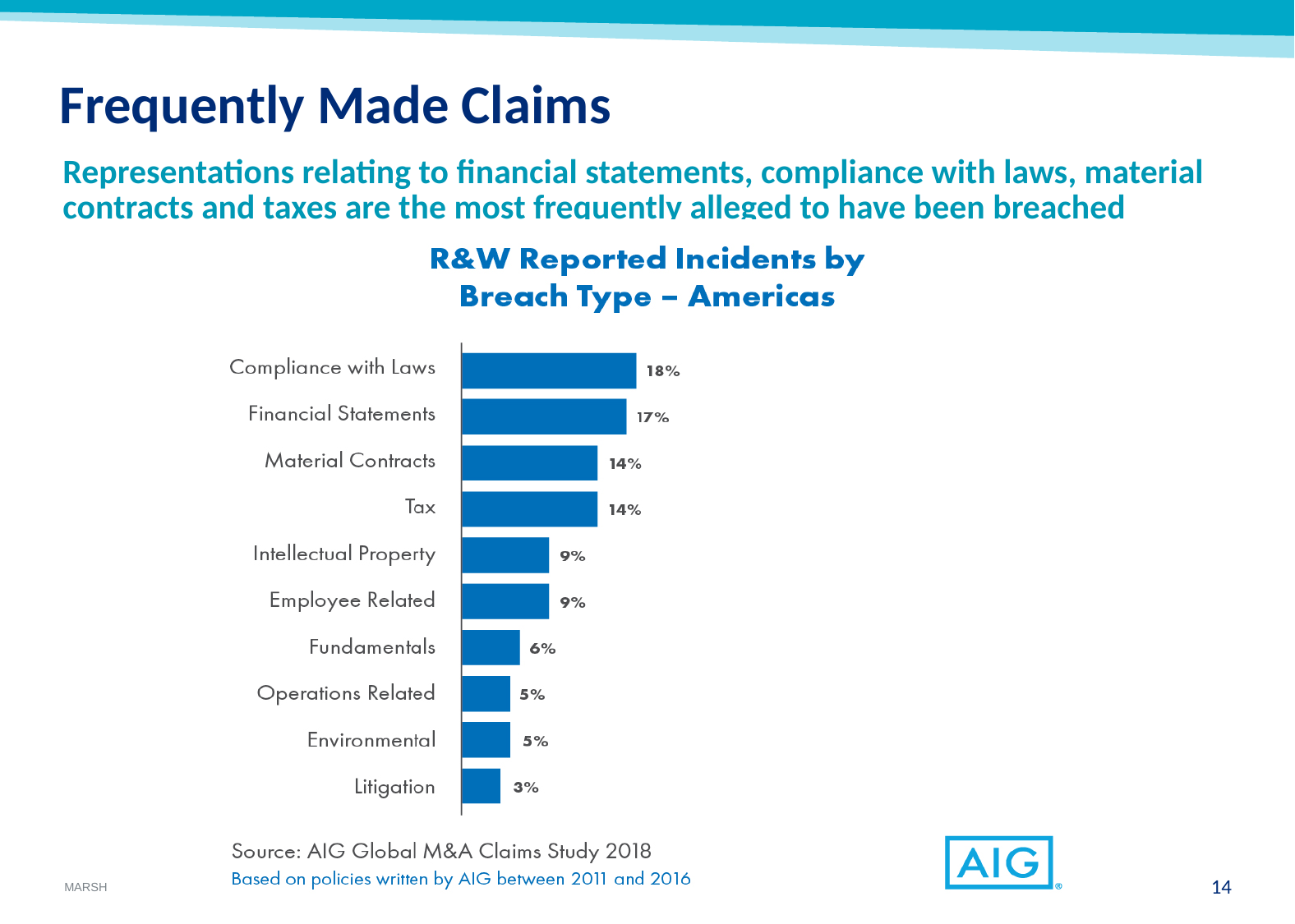
What is the difference between the values for Compliance with Laws and Litigation? 15% What kind of chart is shown on the slide? Bar chart Which is larger, the value for Intellectual Property or the value for Operations Related? Intellectual Property What is the value for Litigation? 3% What is the difference between the values for Financial Statements and Material Contracts? 3% Which breach type has the lowest share of reported incidents? Litigation What is the title of the chart? R&W Reported Incidents by Breach Type – Americas What is the value for Financial Statements? 17% How many breach types are shown in the chart? 10 Which breach type has the highest share of reported incidents? Compliance with Laws What is the value for Compliance with Laws? 18% What is the value for Fundamentals? 6%